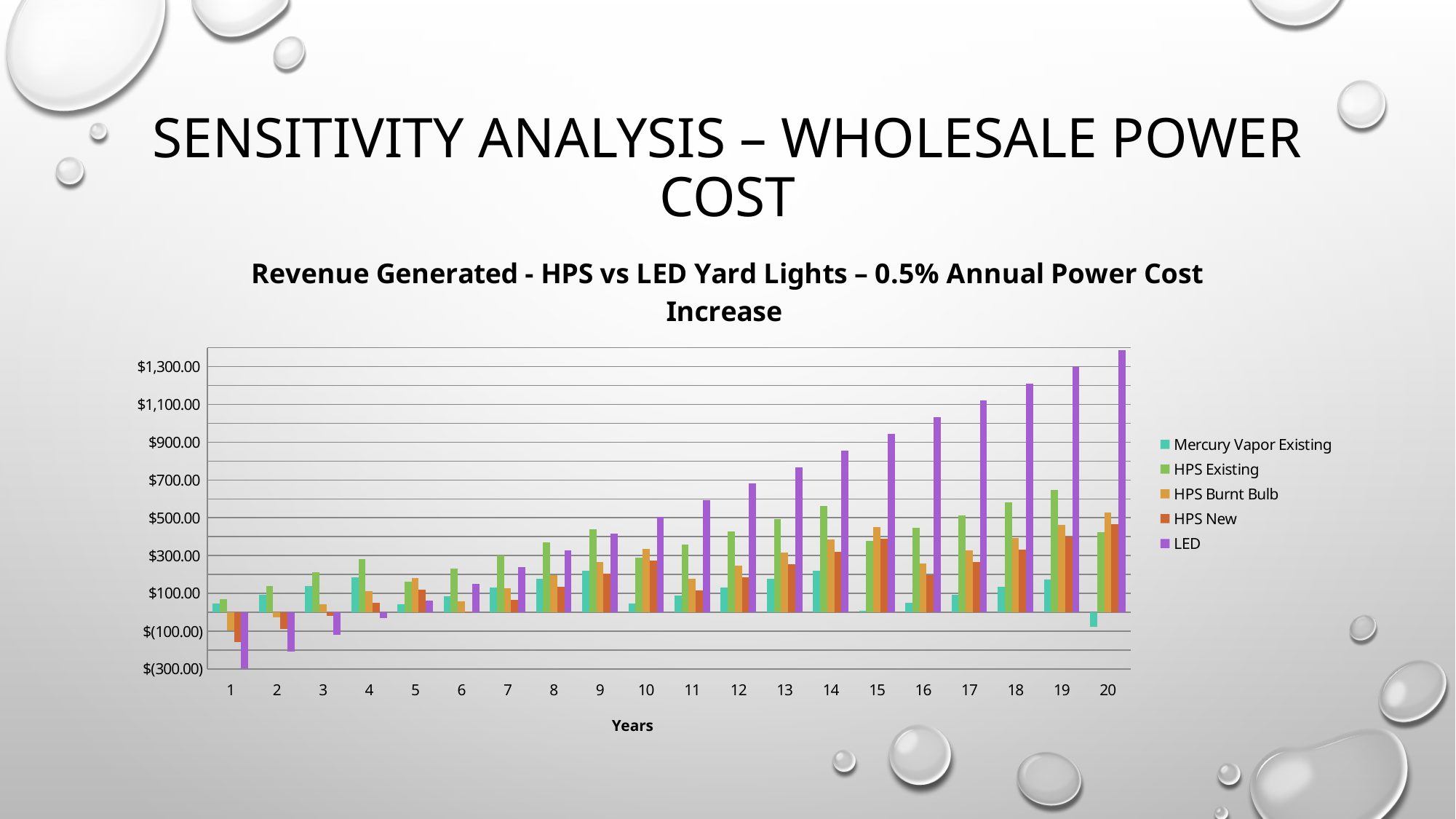
What is the title of the x axis? Years Is the Mercury Vapor Existing value in year 20 greater or less than $100.00? less Which series has the lowest value in year 1? LED How many years are shown along the x axis? 20 Is the HPS Existing value in year 19 greater or less than $700.00? less Is the LED value in year 18 greater or less than $1,100.00? greater Does the LED series rise or fall as the years increase? rise What kind of chart is shown on the slide? bar chart How many series does the legend list? 5 Which series has the highest value in year 20? LED In year 20, which is larger: the LED value or the HPS Existing value? LED